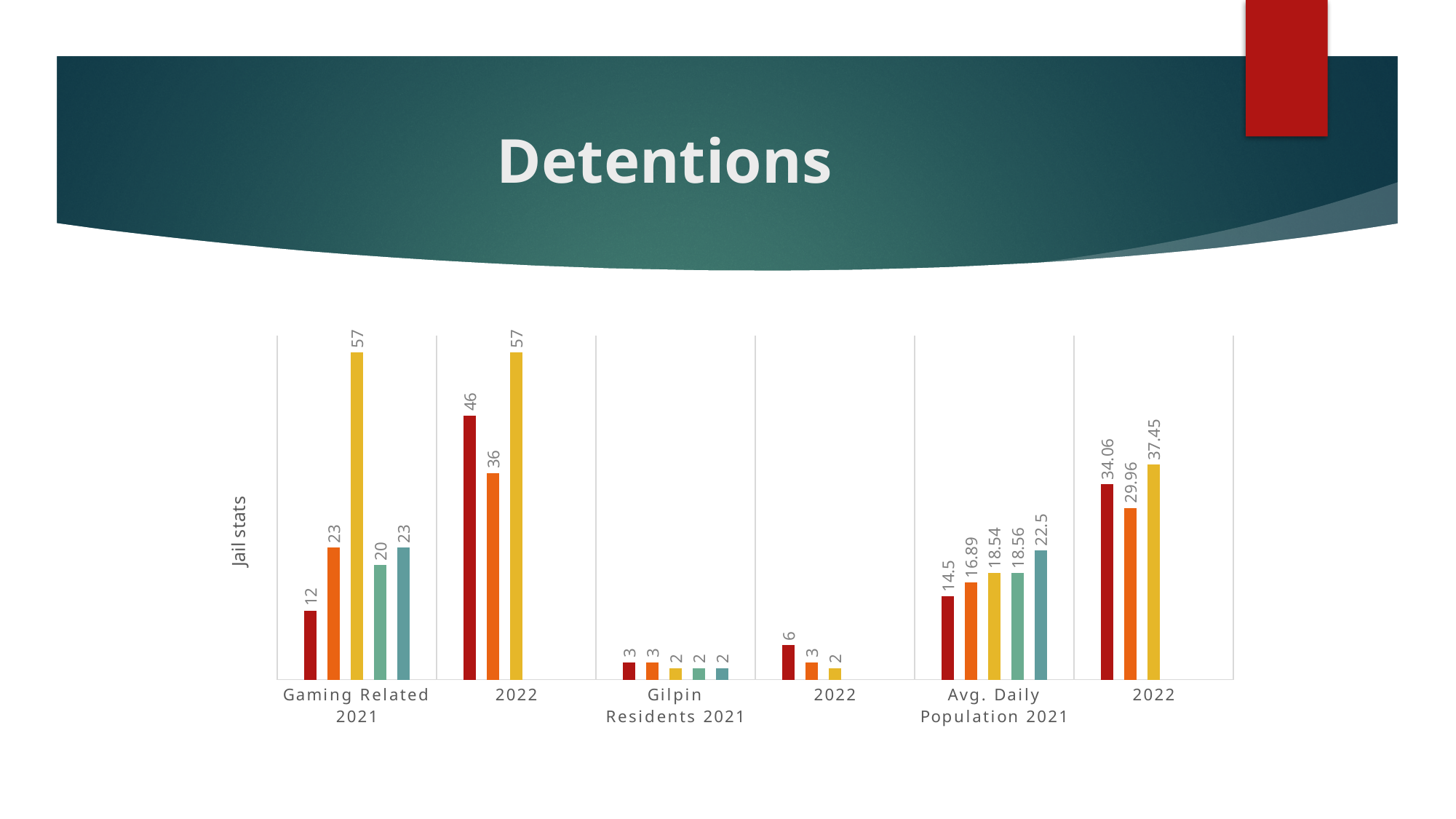
What is the value of the red bar in the Gaming Related 2021 group? 12 What is the difference between the red bar (46) and the orange bar (36) in the 2022 group next to Gaming Related 2021? 10 Which bar is the highest in the Avg. Daily Population 2021 group? the teal bar (22.5) What is the value of the yellow bar in the Gaming Related 2021 group? 57 What kind of chart is shown on the slide? bar chart What is the value of the teal (rightmost) bar in the Avg. Daily Population 2021 group? 22.5 What is the label on the vertical axis of the chart? Jail stats What is the value of the yellow bar in the 2022 group next to Avg. Daily Population 2021? 37.45 What is the value of the red bar in the 2022 group next to Gaming Related 2021? 46 In the 2022 group next to Avg. Daily Population 2021, which is larger: the red bar or the orange bar? the red bar (34.06) Which bar is the lowest in the Gaming Related 2021 group? the red bar (12) How many category groups are shown along the x axis of the chart? 6